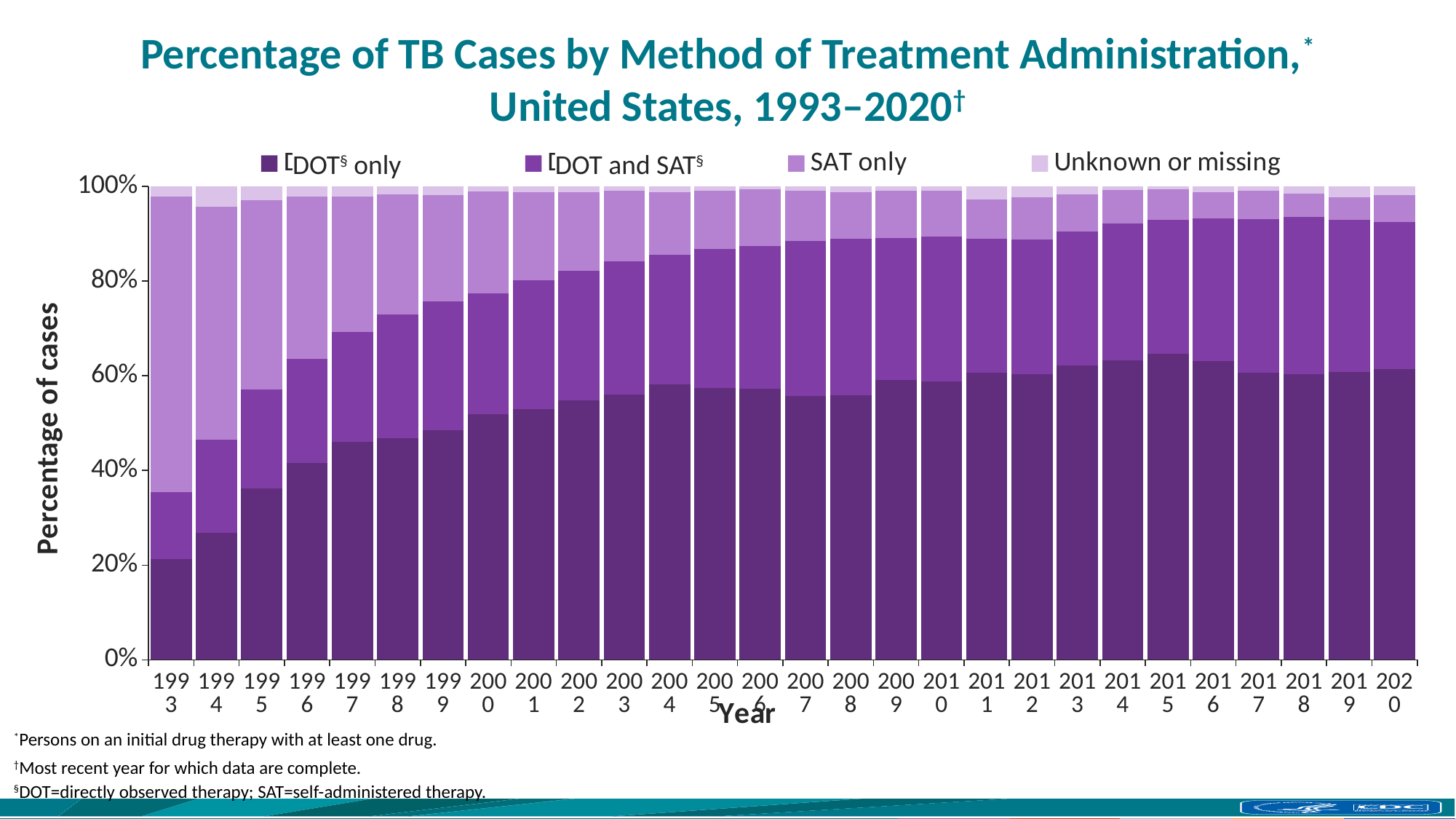
What kind of chart is shown on the slide? Stacked bar chart How many series does the legend list? 4 Does the DOT only share generally rise or fall from 1993 to 2020? Rise Is the DOT only share in 1993 greater or less than 40%? less Is the DOT only share in 2020 greater or less than 40%? greater In which year is the SAT only share the highest? 1993 How many years are shown along the x axis? 28 What is the label of the y axis? Percentage of cases Does the SAT only share generally rise or fall from 1993 to 2020? Fall What is the title of the chart? Percentage of TB Cases by Method of Treatment Administration, United States, 1993–2020 In which year is the DOT only share the lowest? 1993 Which year has the larger DOT only share, 1993 or 2020? 2020